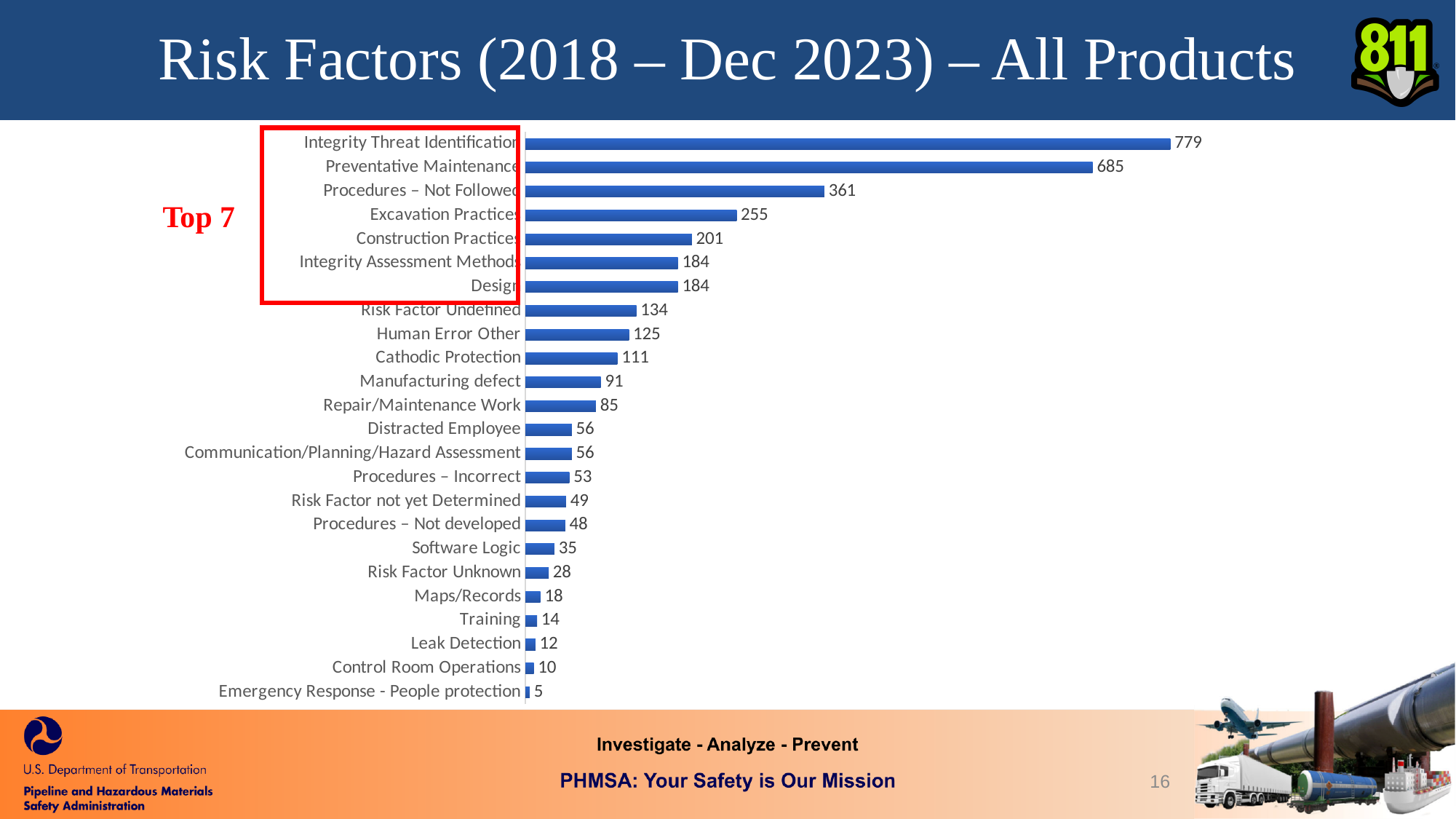
What is the value for Cathodic Protection? 111 Which risk factor has the lowest value? Emergency Response - People protection What is the difference between the values for Integrity Threat Identification and Preventative Maintenance? 94 Which is larger, the value for Human Error Other or the value for Manufacturing defect? Human Error Other What is the title of the slide containing the chart? Risk Factors (2018 – Dec 2023) – All Products What kind of chart is shown on the slide? Bar chart How many risk factor categories are shown in the chart? 24 Which is larger, the value for Maps/Records or the value for Training? Maps/Records What is the value for Software Logic? 35 What is the difference between the values for Procedures – Not Followed and Excavation Practices? 106 Which risk factor has the highest value? Integrity Threat Identification What is the value for Integrity Threat Identification? 779